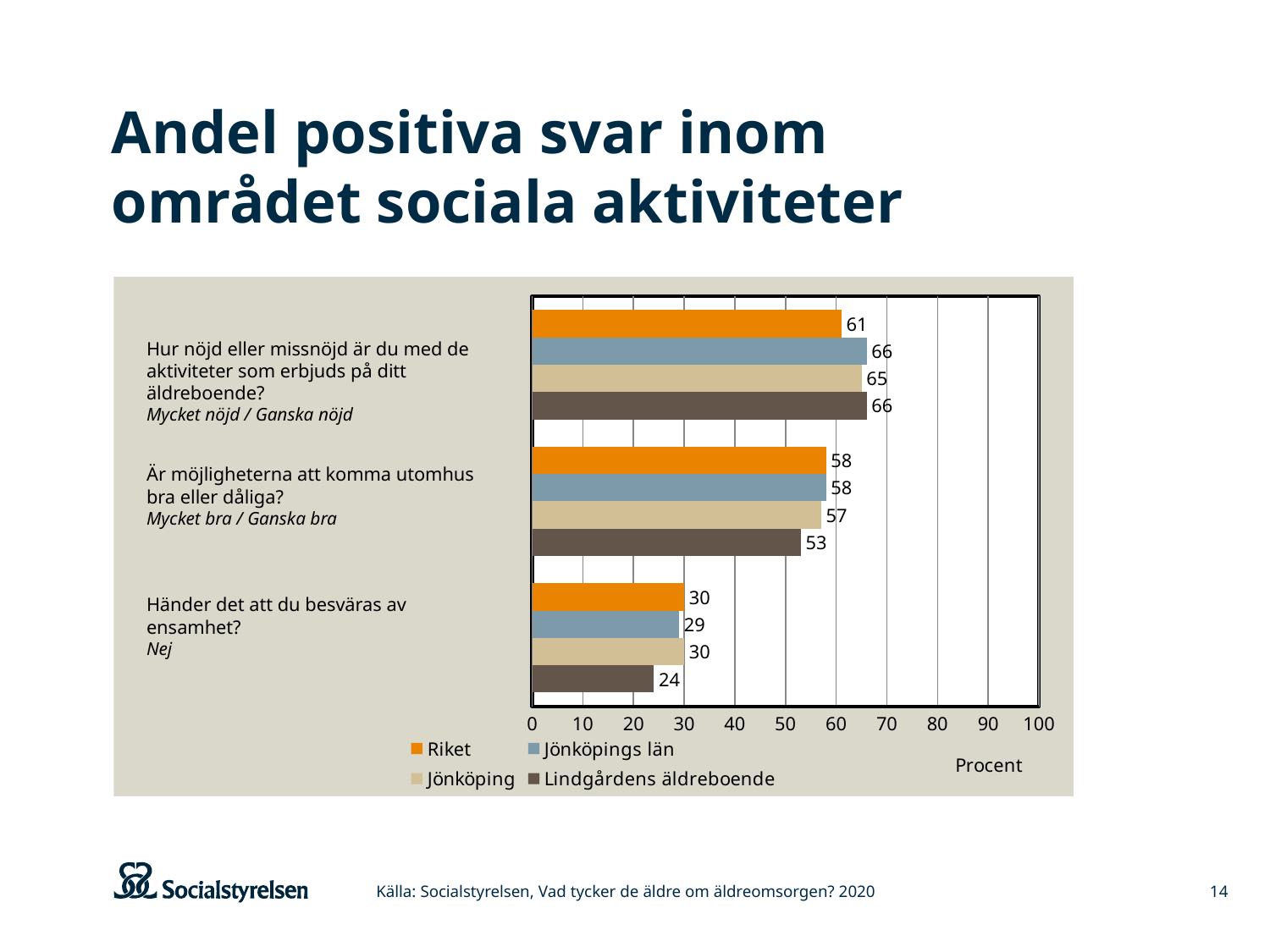
What is the value for Riket on the question "Hur nöjd eller missnöjd är du med de aktiviteter som erbjuds på ditt äldreboende?"? 61 How many question categories are shown on the chart? 3 How many series does the legend list? 4 What is the difference between Jönköpings län and Riket on the question "Hur nöjd eller missnöjd är du med de aktiviteter som erbjuds på ditt äldreboende?"? 5 What is the difference between Riket and Lindgårdens äldreboende on the question "Händer det att du besväras av ensamhet?"? 6 What is the value for Jönköping on the question "Är möjligheterna att komma utomhus bra eller dåliga?"? 57 What kind of chart is shown on the slide? Bar chart Which is larger on the question "Är möjligheterna att komma utomhus bra eller dåliga?": Riket or Lindgårdens äldreboende? Riket Which series has the lowest value on the question "Är möjligheterna att komma utomhus bra eller dåliga?"? Lindgårdens äldreboende Which series has the lowest value on the question "Hur nöjd eller missnöjd är du med de aktiviteter som erbjuds på ditt äldreboende?"? Riket What is the label of the horizontal axis? Procent What is the value for Lindgårdens äldreboende on the question "Händer det att du besväras av ensamhet?"? 24